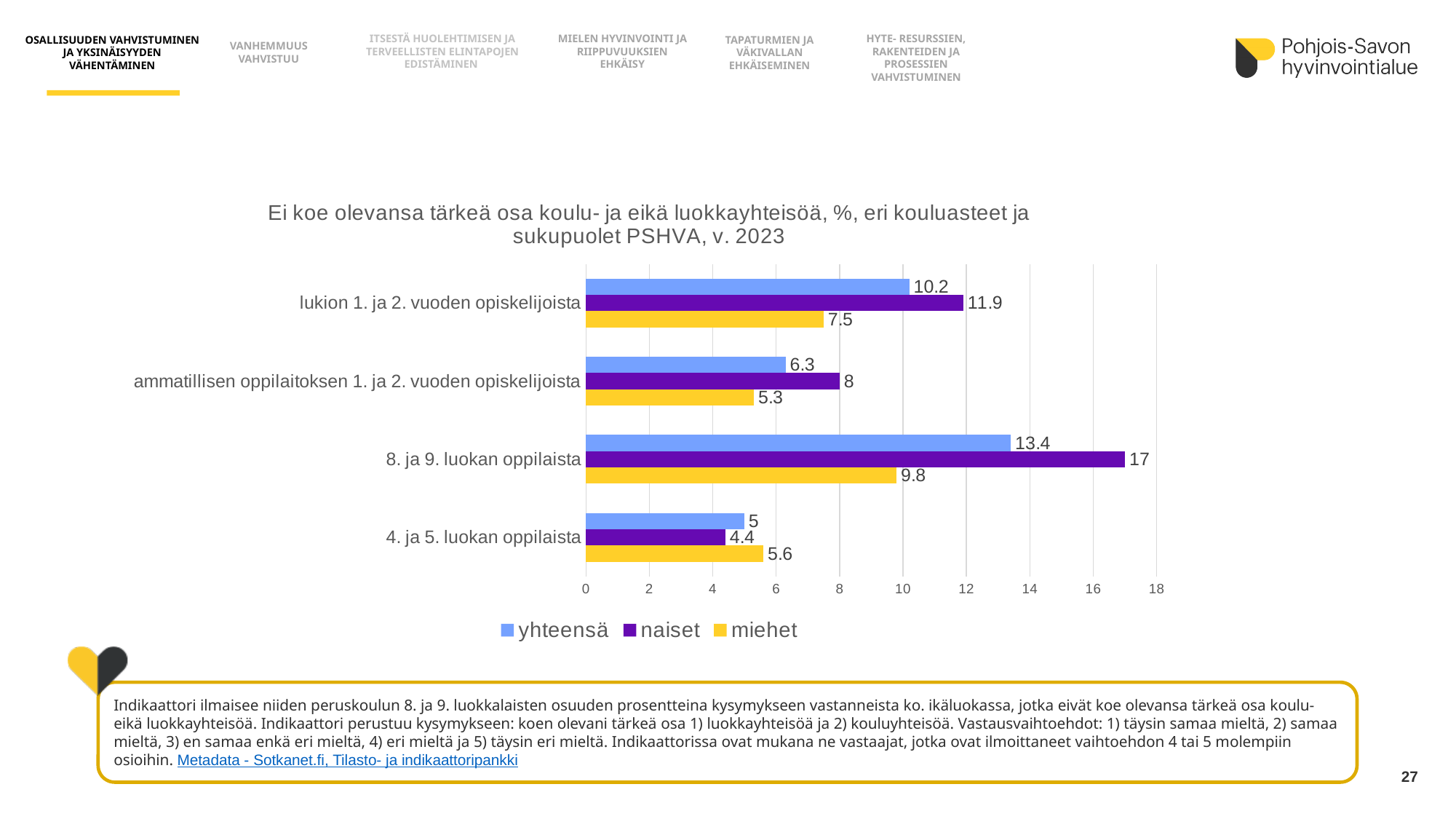
Which colour represents the miehet series? yellow Which category has the highest naiset value? 8. ja 9. luokan oppilaista What is the yhteensä value for ammatillisen oppilaitoksen 1. ja 2. vuoden opiskelijoista? 6.3 What is the value for naiset among 8. ja 9. luokan oppilaista? 17 What kind of chart is shown on the slide? bar chart What is the value for miehet among lukion 1. ja 2. vuoden opiskelijoista? 7.5 What is the difference between the naiset and miehet values for 8. ja 9. luokan oppilaista? 7.2 Is the yhteensä value for 8. ja 9. luokan oppilaista greater or less than 12? greater How many categories are shown on the chart? 4 How many series does the legend list? 3 Which category has the lowest miehet value? ammatillisen oppilaitoksen 1. ja 2. vuoden opiskelijoista For 4. ja 5. luokan oppilaista, which is larger: the naiset value or the miehet value? miehet